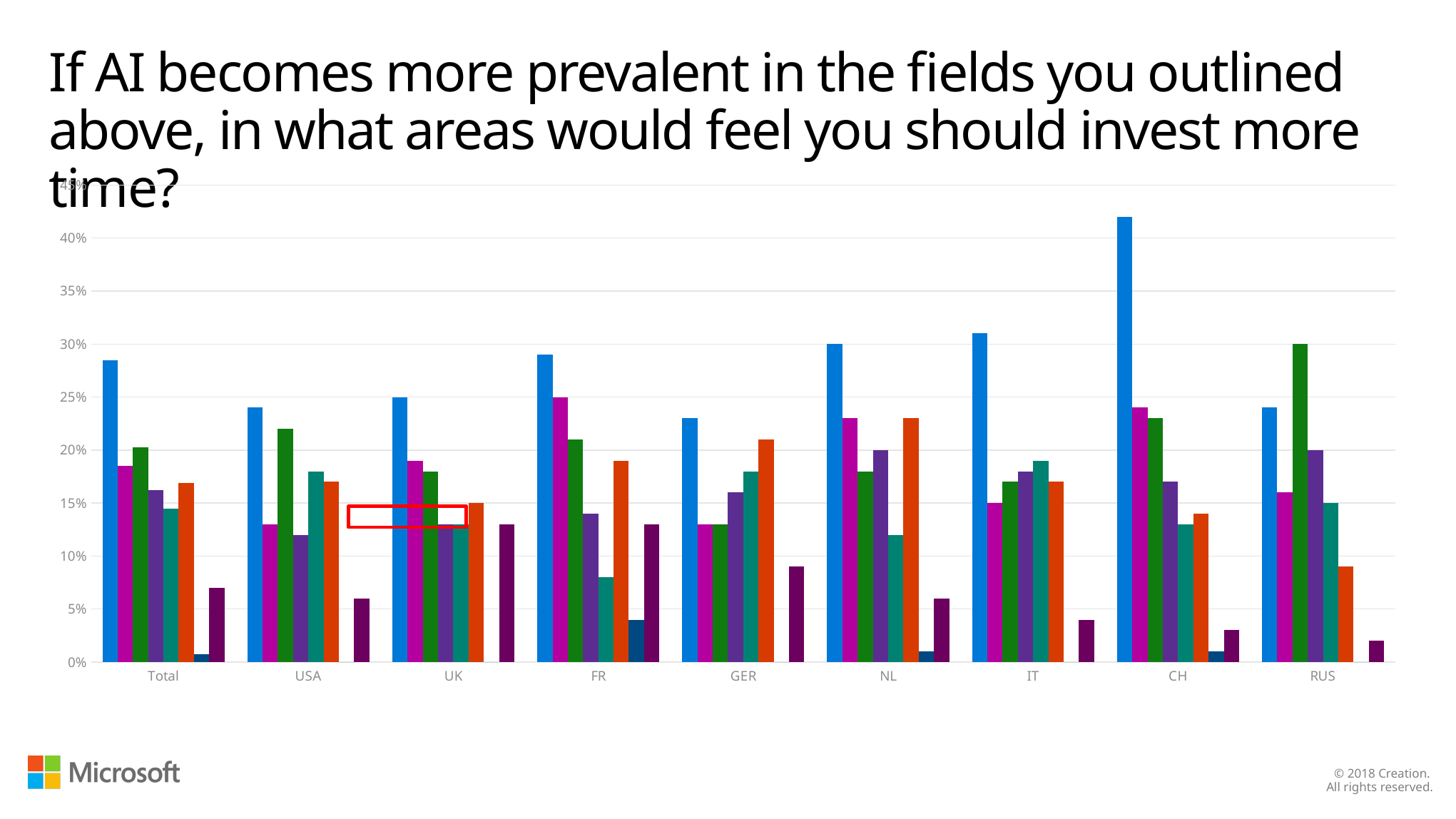
Is the leftmost bar for GER greater or less than 25%? less Is the rightmost bar for RUS greater or less than 5%? less Which is larger: the rightmost bar for UK or the rightmost bar for CH? UK Is the tallest bar for CH greater or less than 40%? greater How many categories are shown along the x axis? 9 What is the label of the first category on the x axis? Total What is the highest value labelled on the y axis? 45% Which category contains the tallest bar in the chart? CH Which is larger: the leftmost bar for CH or the leftmost bar for GER? CH What kind of chart is shown on the slide? bar chart